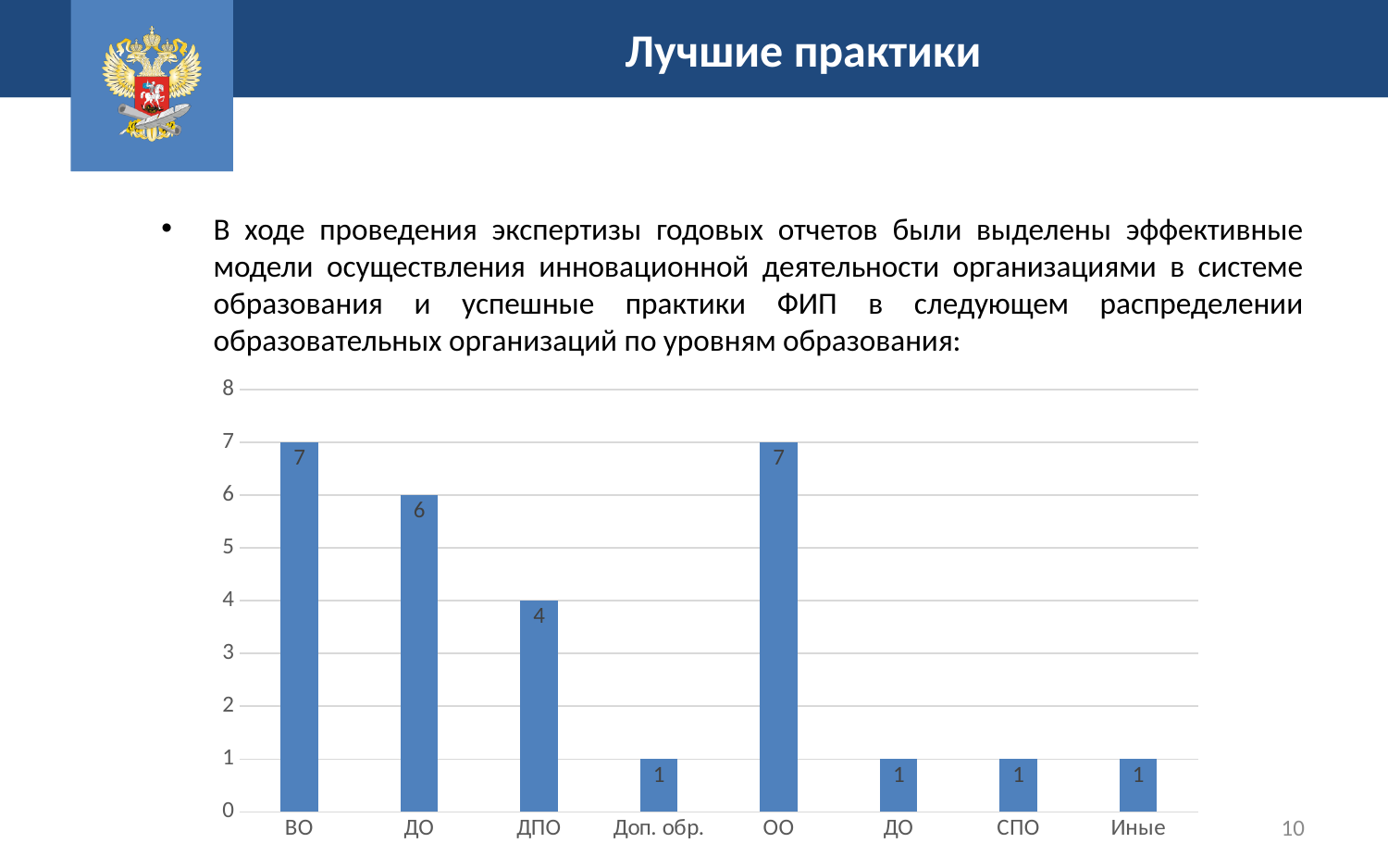
Which is larger, the value for ДПО or the value for Иные? ДПО What is the value for ОО? 7 What is the difference between the values for ОО and Доп. обр.? 6 What is the value for ВО? 7 What kind of chart is shown on the slide? bar chart How many categories are shown on the x axis of the chart? 8 Is the value for ДПО greater or less than 5? less Which two categories share the highest value on the chart? ВО and ОО What is the value for ДПО? 4 What is the difference between the values for ВО and ДПО? 3 What is the value for СПО? 1 What is the value for the ДО bar that appears second from the left, between ВО and ДПО? 6